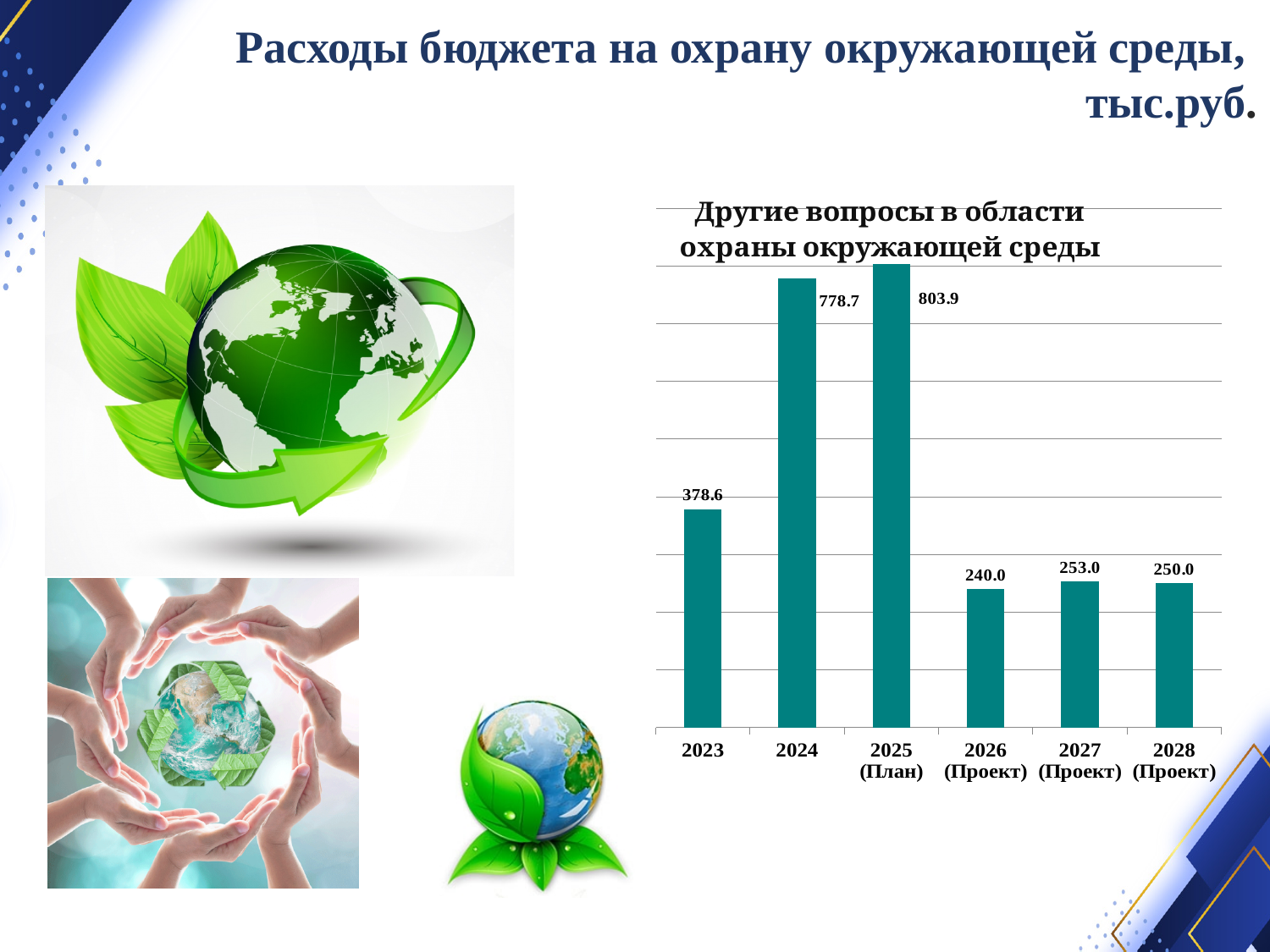
Do the values rise or fall from 2025 (План) to 2026 (Проект)? fall What is the value for 2023? 378.6 Which is larger, the value for 2027 (Проект) or the value for 2028 (Проект)? 2027 (Проект) What is the title of the chart? Другие вопросы в области охраны окружающей среды What is the value for 2027 (Проект)? 253.0 Which year has the lowest value? 2026 (Проект) What kind of chart is shown on the slide? bar chart What is the difference between the values for 2025 (План) and 2024? 25.2 Which year has the highest value? 2025 (План) What is the difference between the values for 2024 and 2023? 400.1 How many years are shown on the x axis? 6 What is the value for 2025 (План)? 803.9